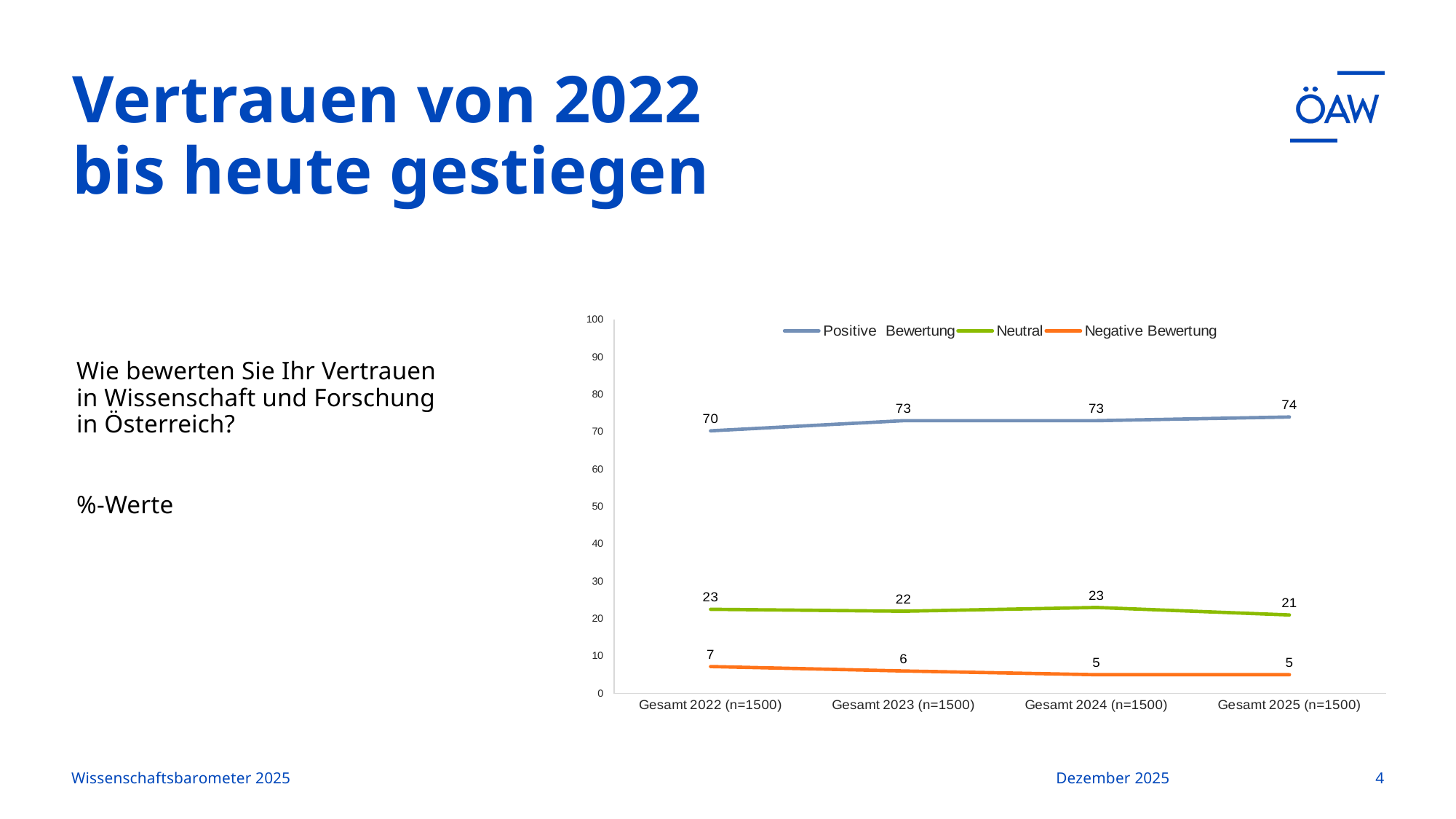
How many years are shown on the x axis? 4 What is the value for Negative Bewertung in Gesamt 2025 (n=1500)? 5 In which year is Neutral lowest? Gesamt 2025 (n=1500) What kind of chart is shown on the slide? line chart Which is larger: Negative Bewertung in Gesamt 2022 (n=1500) or in Gesamt 2023 (n=1500)? Gesamt 2022 (n=1500) Does Negative Bewertung rise or fall from Gesamt 2022 (n=1500) to Gesamt 2025 (n=1500)? fall In which year is Positive Bewertung highest? Gesamt 2025 (n=1500) What is the value for Neutral in Gesamt 2024 (n=1500)? 23 How many series does the legend list? 3 What is the value for Positive Bewertung in Gesamt 2022 (n=1500)? 70 What is the difference between Positive Bewertung in Gesamt 2025 (n=1500) and Gesamt 2022 (n=1500)? 4 Is the value for Positive Bewertung in Gesamt 2023 (n=1500) greater or less than 60? greater